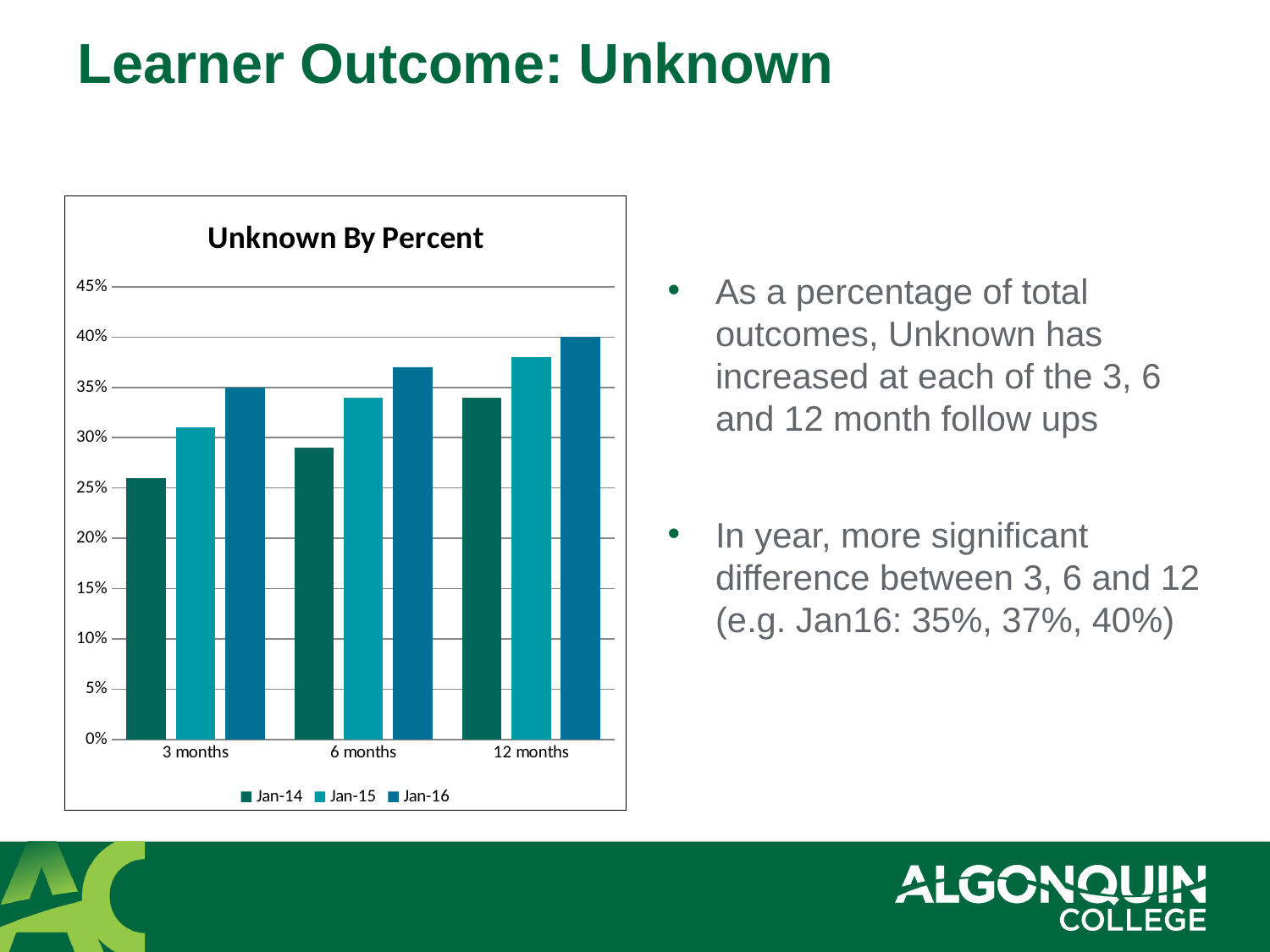
What is the title of the chart? Unknown By Percent What is the value for Jan-16 at 3 months? 35% What is the difference between the Jan-16 values at 12 months and 3 months? 5% Is the value for Jan-15 at 12 months greater or less than 35%? greater What kind of chart is shown on the slide? bar chart Is the value for Jan-14 at 3 months greater or less than 30%? less What is the value for Jan-16 at 12 months? 40% Which is larger at 3 months, Jan-15 or Jan-16? Jan-16 Which series has the highest value at 12 months? Jan-16 How many categories are shown on the x axis of the chart? 3 How many series does the legend of the chart list? 3 Which bar is the lowest in the chart? Jan-14 at 3 months